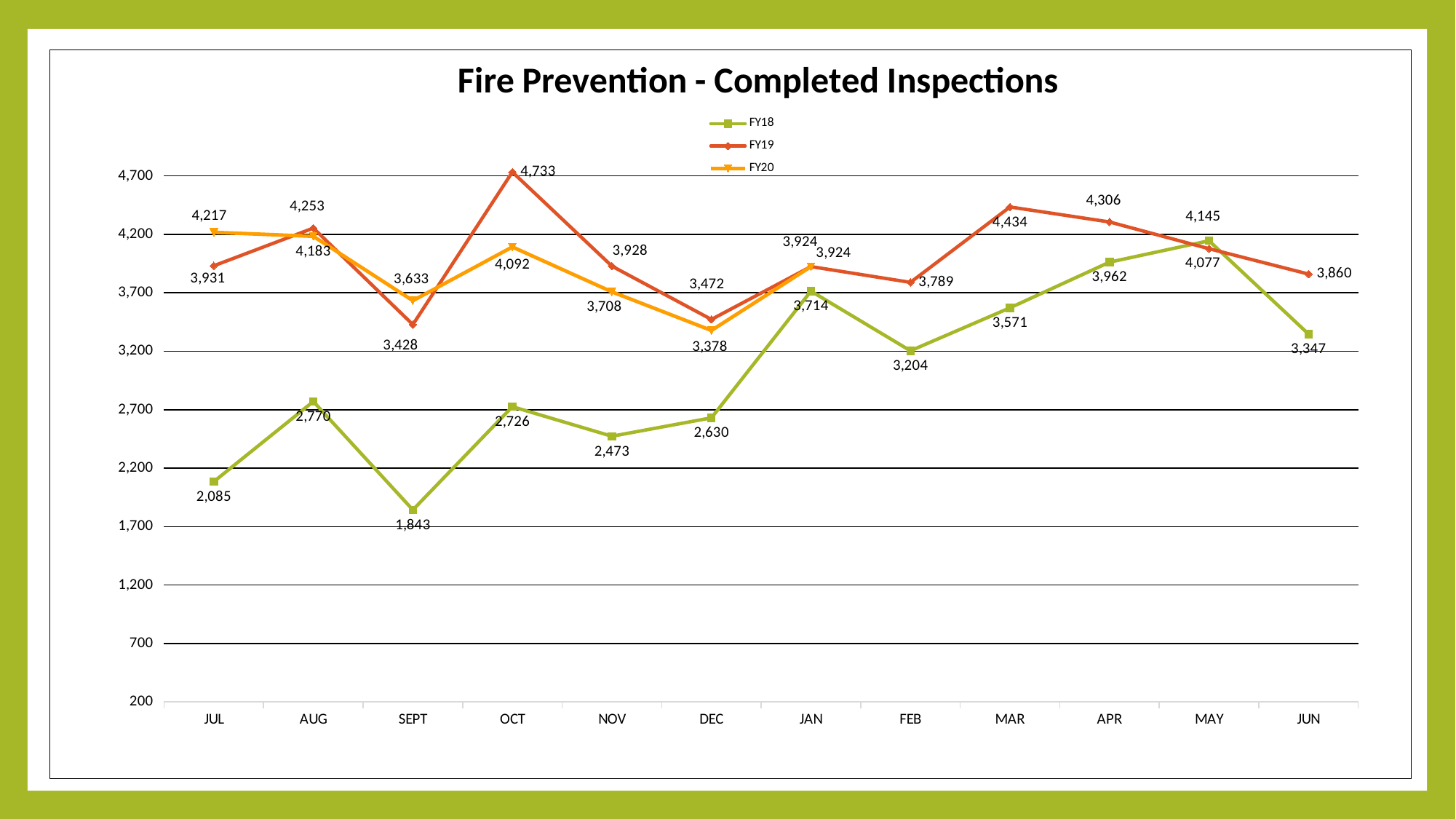
What is the FY18 value for SEPT? 1,843 How many series does the legend list? 3 What is the difference between the FY19 and FY18 values for OCT? 2,007 What is the FY19 value for OCT? 4,733 Which series has the larger value in AUG, FY19 or FY20? FY19 In which month is the FY19 value highest? OCT What is the FY18 value for MAY? 4,145 What kind of chart is shown on the slide? line chart How many months are shown on the x axis? 12 In which month is the FY18 value lowest? SEPT What is the FY20 value for JUL? 4,217 Does the FY18 line rise or fall from JUL to AUG? rise